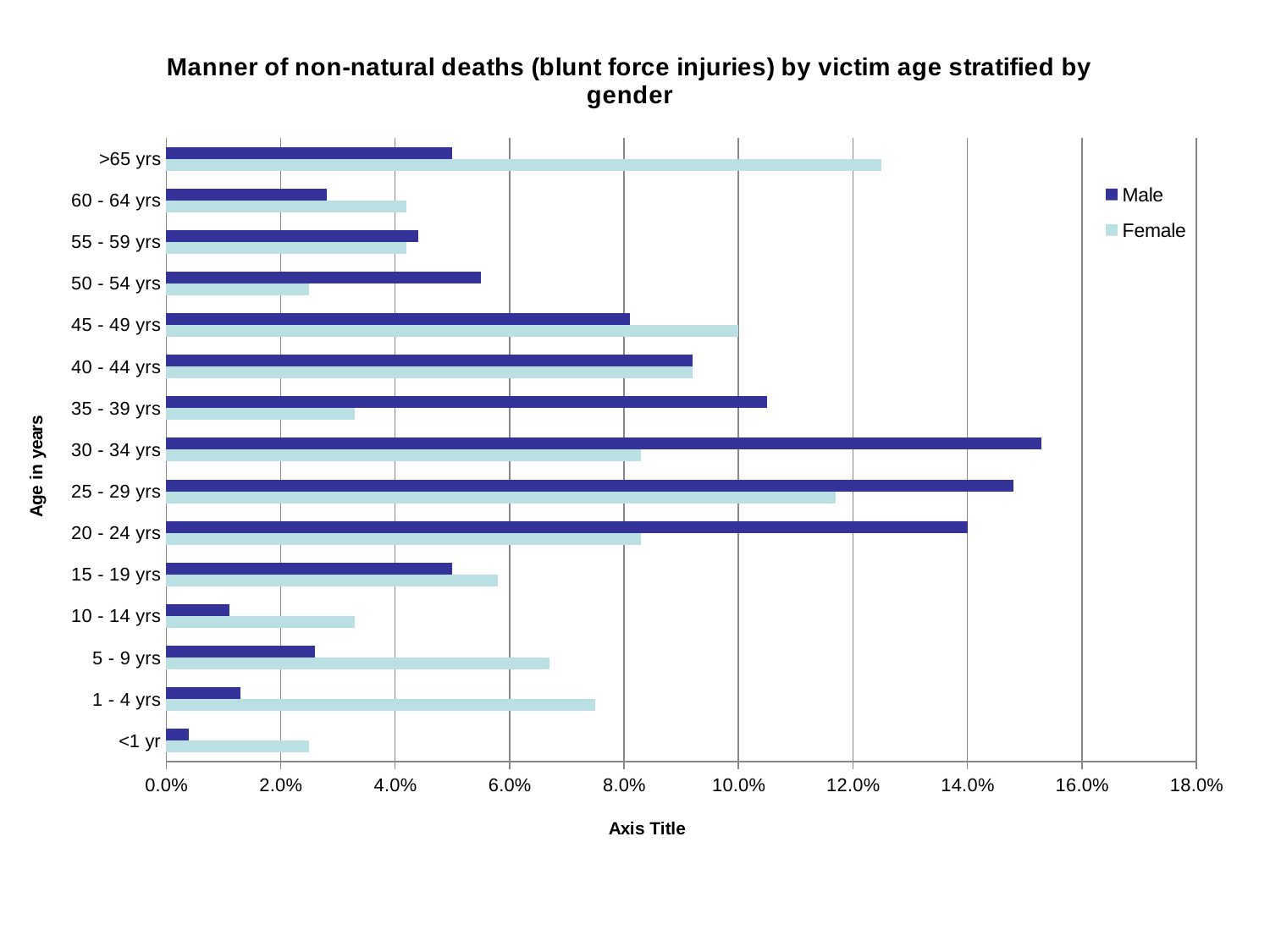
Is the Female value for 1 - 4 yrs greater or less than 6.0%? greater Is the Male value for <1 yr greater or less than 2.0%? less Which age category has the lowest Male value? <1 yr For the >65 yrs category, which is larger, the Male or the Female value? Female What is the label on the vertical axis of the chart? Age in years How many age categories are plotted on the chart? 15 Which age category has the highest Male value? 30 - 34 yrs What kind of chart is shown on the slide? bar chart How many series does the legend list? 2 Is the Male value for 30 - 34 yrs greater or less than 14.0%? greater For the 35 - 39 yrs category, which is larger, the Male or the Female value? Male Which age category has the highest Female value? >65 yrs